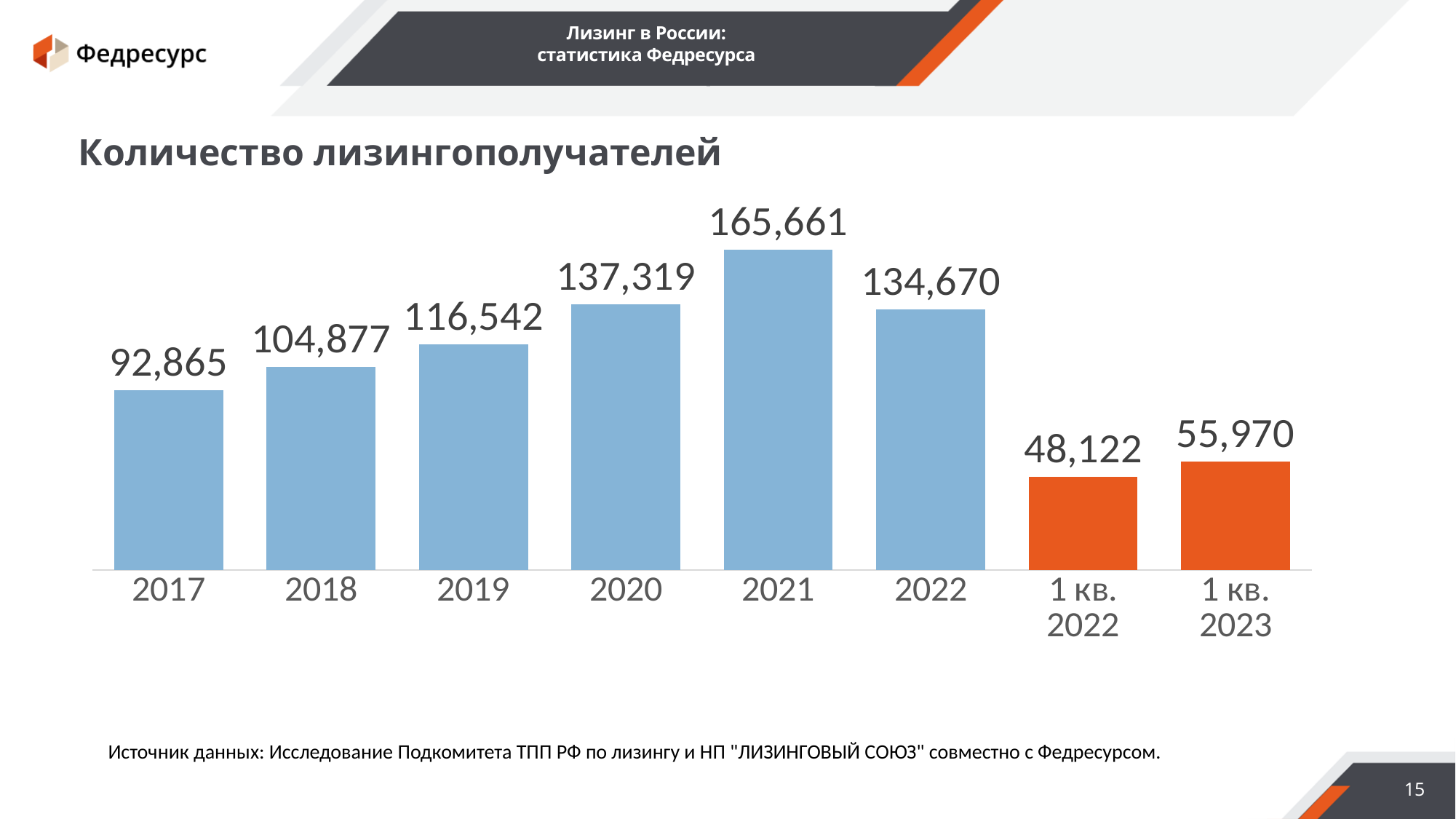
Which category has the highest value? 2021 Do the values rise or fall from 2017 to 2021? Rise What is the number of lessees shown for 2021? 165,661 What is the title of the chart? Количество лизингополучателей Which is larger, the value for 2020 or the value for 2022? 2020 What is the difference between the values for 2021 and 2022? 30,991 What is the difference between the values for 1 кв. 2023 and 1 кв. 2022? 7,848 How many bars are shown in the chart? 8 What type of chart is shown on the slide? Bar chart What is the value for 2017? 92,865 Which category has the lowest value? 1 кв. 2022 What value is shown for 1 кв. 2023? 55,970